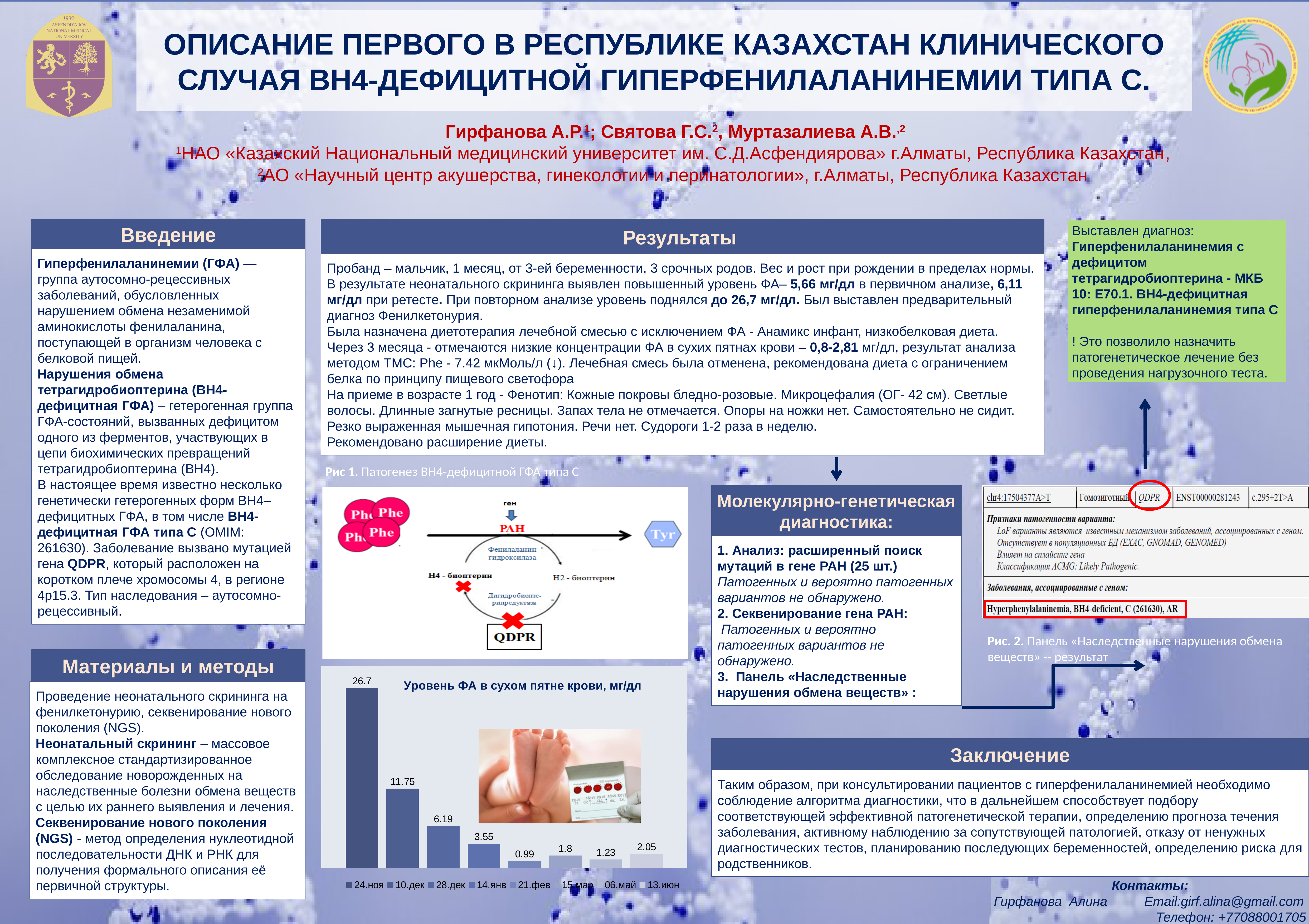
What kind of chart is used to show the ФА level in dried blood spots? bar chart How many entries does the legend of the chart list? 8 What is the value for 14.янв in the chart? 3.55 What is the value for 13.июн in the chart? 2.05 Which date has the lowest ФА level in the chart? 21.фев Which is larger, the value for 28.дек or the value for 14.янв? 28.дек Which date has the highest ФА level in the chart? 24.ноя What is the value for 24.ноя in the chart? 26.7 What is the value for 10.дек in the chart? 11.75 How many bars are plotted in the chart 'Уровень ФА в сухом пятне крови, мг/дл'? 8 What is the difference between the values for 24.ноя and 10.дек? 14.95 What is the title of the chart on the slide? Уровень ФА в сухом пятне крови, мг/дл